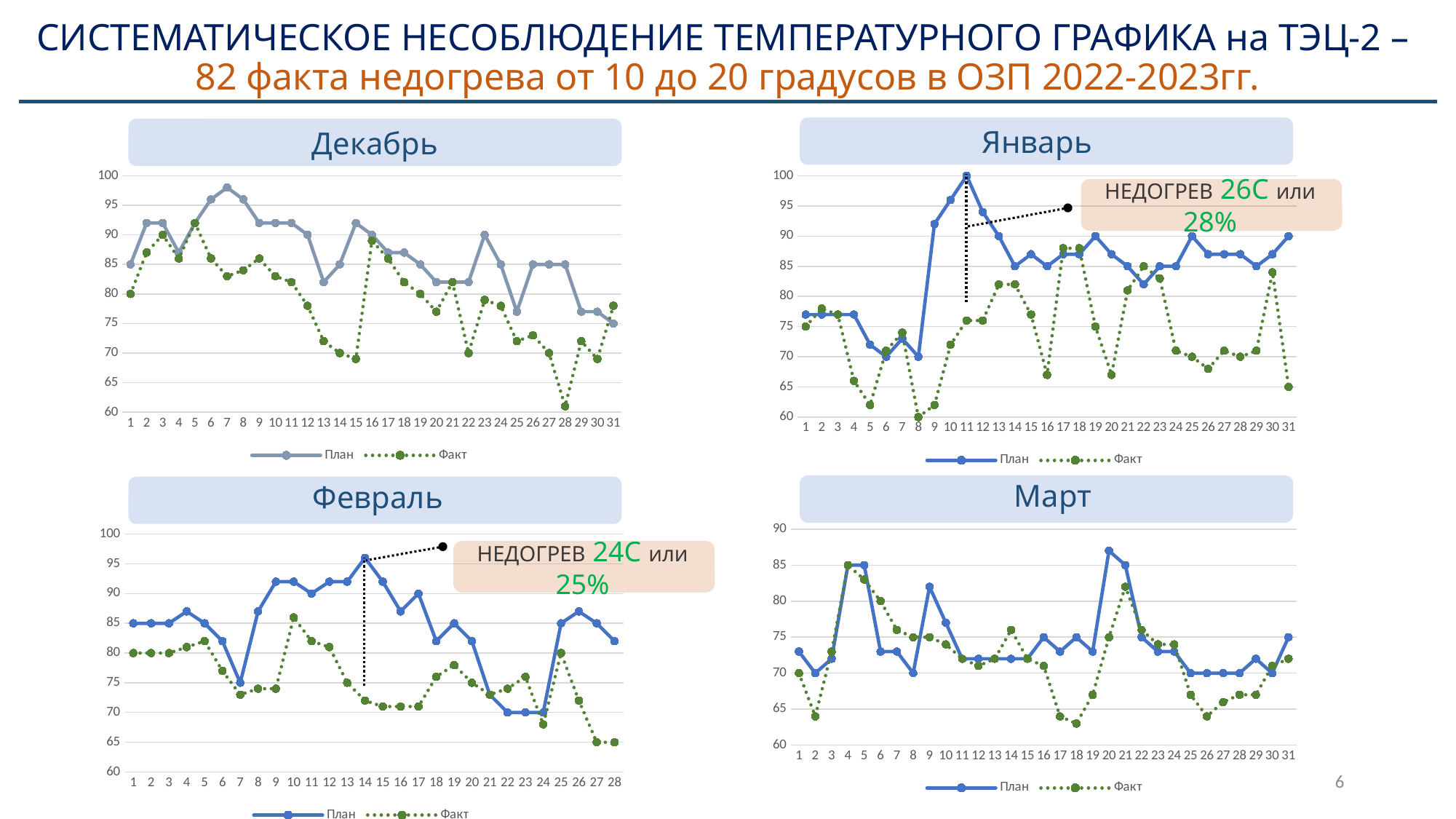
How many points are on the x axis of the Февраль chart? 28 In the Январь chart, on which day is the План value highest? 11 In the Март chart, is the План value on day 20 greater or less than 85? greater In the Март chart, what is the План value on day 4? 85 What kind of chart is the Декабрь chart? line chart In the Март chart, does the План line rise or fall from day 20 to day 26? fall What percentage of underheating (недогрев) is stated in the annotation on the Февраль chart? 25% In the Декабрь chart, on which day is the Факт value lowest? 28 In the Декабрь chart, is the Факт value on day 28 greater or less than 65? less How many series does the legend of the Январь chart list? 2 In the Декабрь chart, which is larger on day 7, План or Факт? План In the Январь chart, what is the План value on day 11? 100